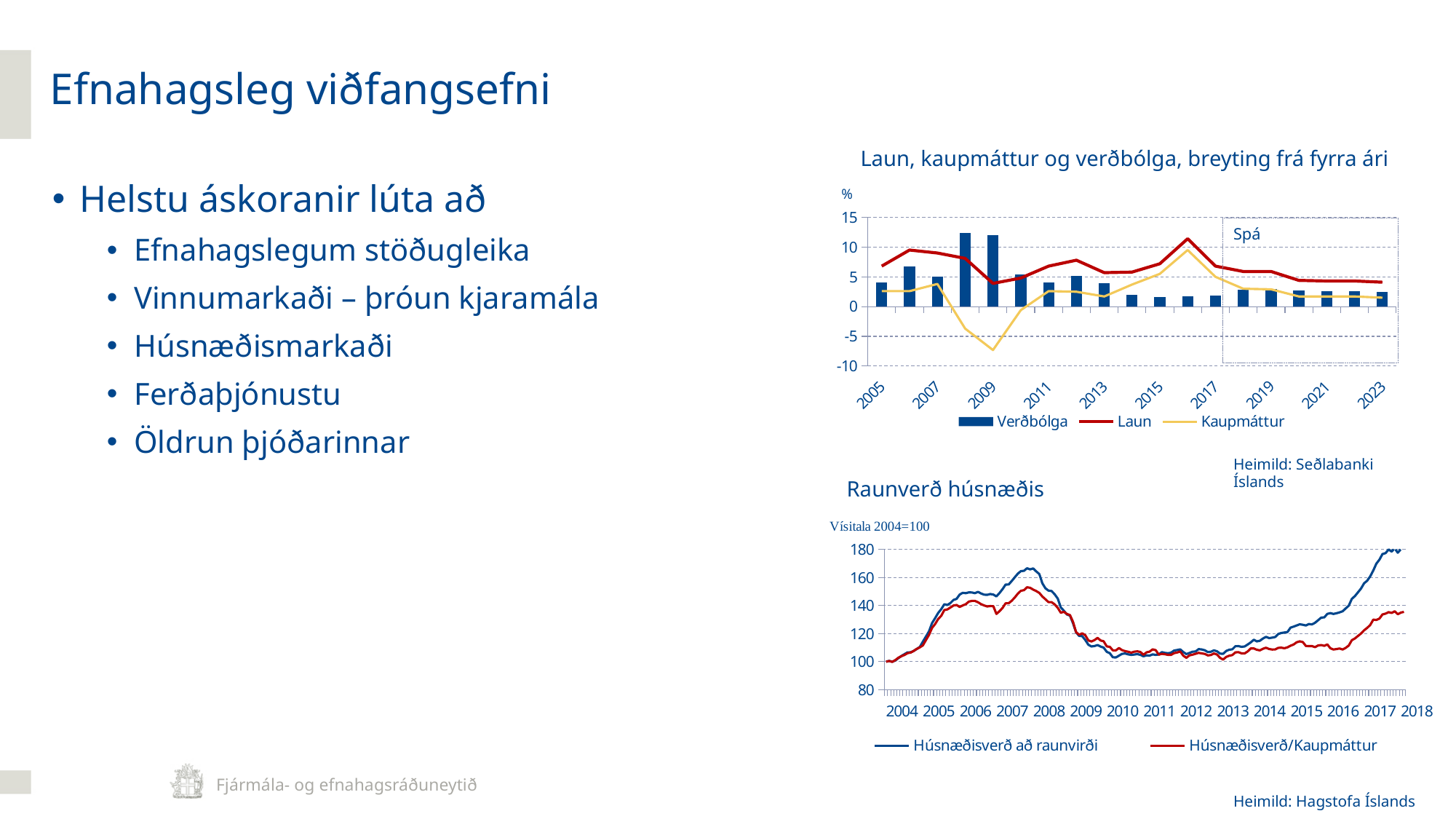
In the chart 'Raunverð húsnæðis', how many series does the legend list? 2 In the chart 'Laun, kaupmáttur og verðbólga, breyting frá fyrra ári', what label marks the shaded forecast area on the right? Spá In the chart 'Laun, kaupmáttur og verðbólga, breyting frá fyrra ári', which series is shown as bars? Verðbólga In the chart 'Laun, kaupmáttur og verðbólga, breyting frá fyrra ári', is the Laun value for 2016 greater or less than 10? greater In the chart 'Raunverð húsnæðis', is the value of Húsnæðisverð að raunvirði at the end of the series (2018) greater or less than 160? greater In the chart 'Laun, kaupmáttur og verðbólga, breyting frá fyrra ári', how many series does the legend list? 3 In the chart 'Raunverð húsnæðis', which series is higher in 2017, Húsnæðisverð að raunvirði or Húsnæðisverð/Kaupmáttur? Húsnæðisverð að raunvirði What kind of chart is 'Raunverð húsnæðis'? line chart In the chart 'Laun, kaupmáttur og verðbólga, breyting frá fyrra ári', is the Verðbólga value for 2008 greater or less than 10? greater In the chart 'Laun, kaupmáttur og verðbólga, breyting frá fyrra ári', in which year is the Kaupmáttur line at its lowest? 2009